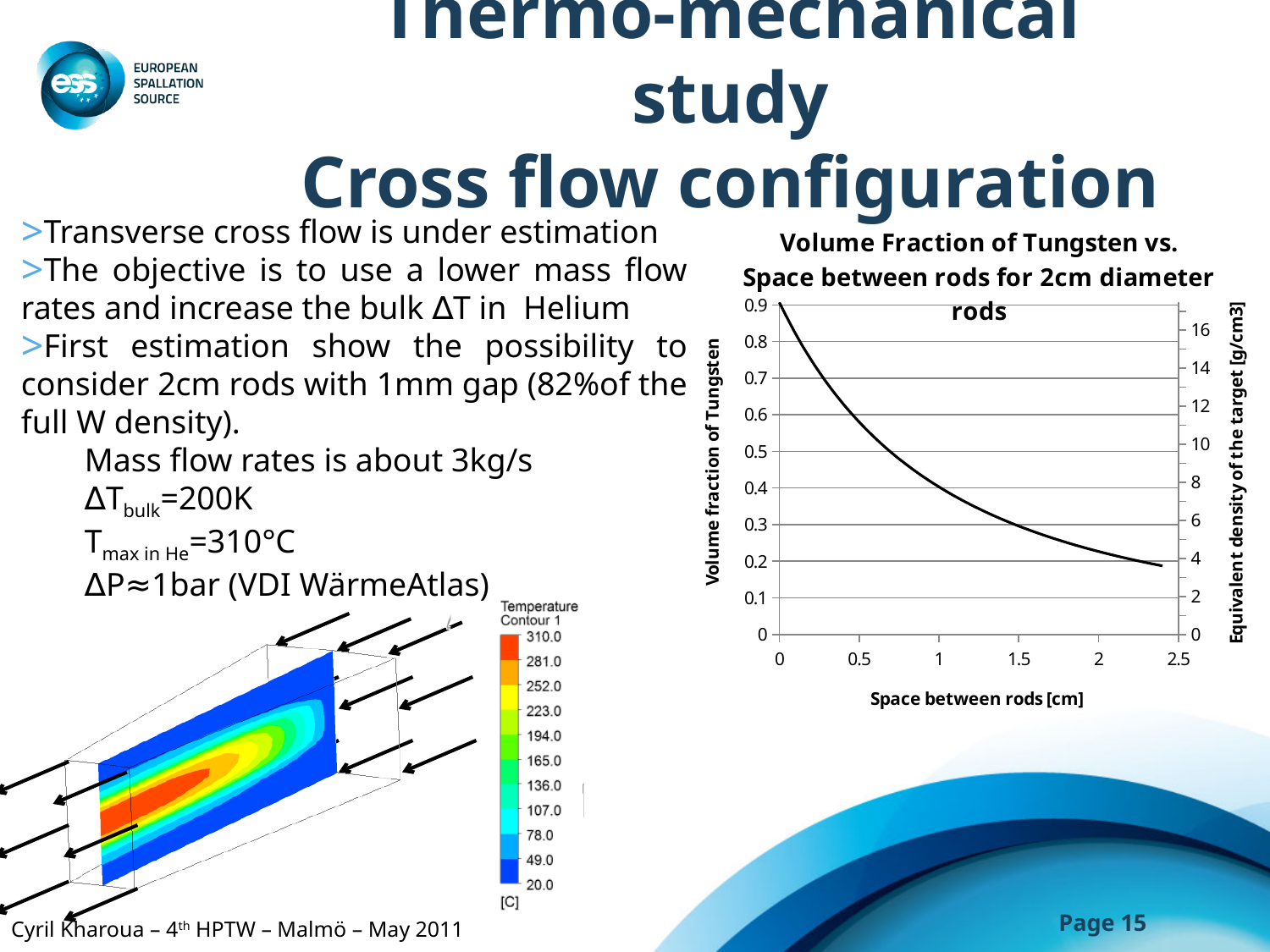
What kind of chart is shown on the slide? line chart What is the label of the x axis of the chart? Space between rods [cm] Which has the larger volume fraction of Tungsten: a space between rods of 0.5 cm or 1.5 cm? 0.5 cm Is the volume fraction of Tungsten at a space between rods of 0.5 cm greater or less than 0.5? greater Is the volume fraction of Tungsten at a space between rods of 1 cm greater or less than 0.6? less Is the volume fraction of Tungsten at a space between rods of 2 cm greater or less than 0.3? less Does the volume fraction of Tungsten rise or fall as the space between rods increases? fall What is the title of the chart? Volume Fraction of Tungsten vs. Space between rods for 2cm diameter rods